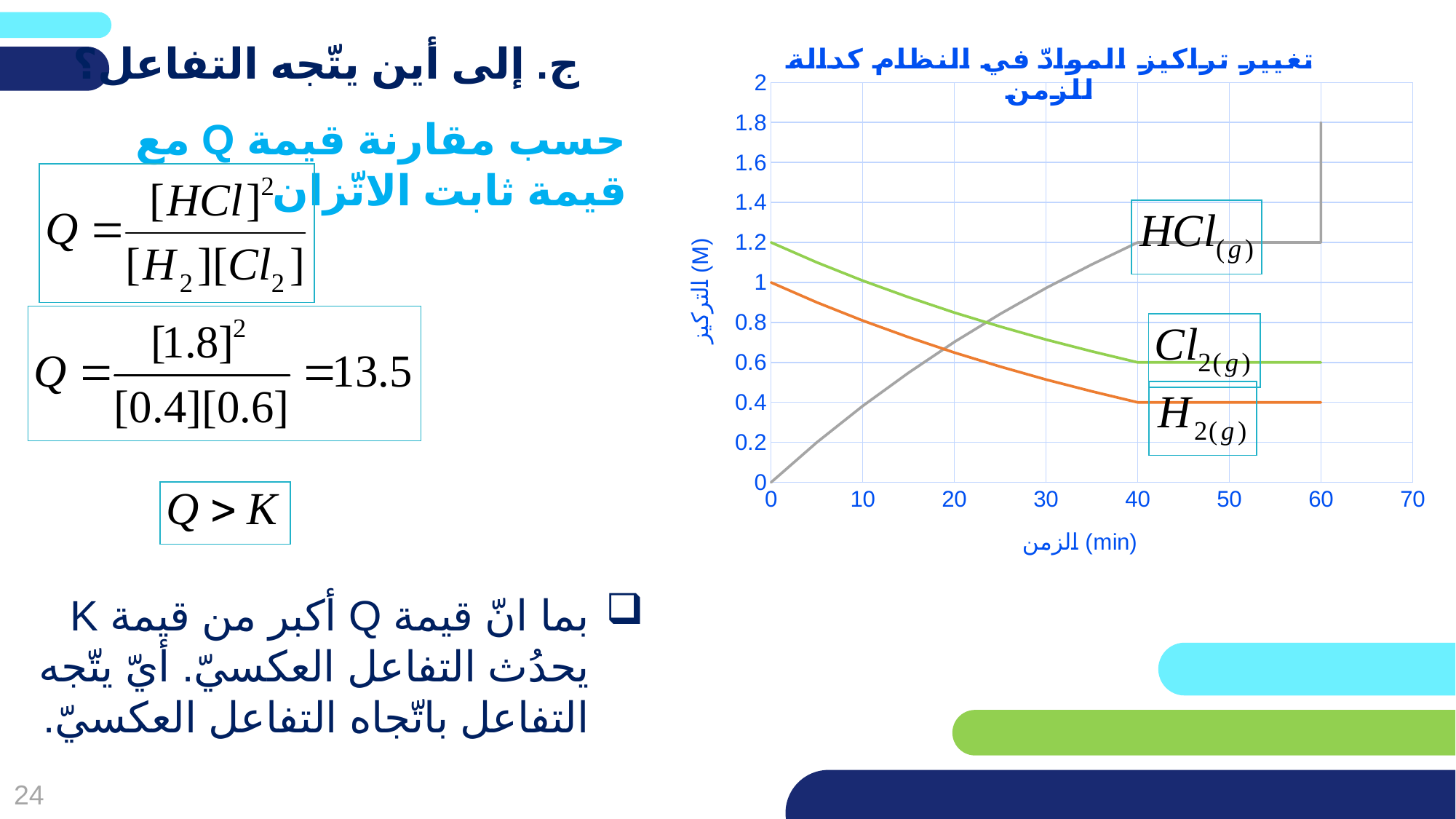
What is the initial concentration of Cl2(g) at 0 min? 1.2 What is the concentration of H2(g) at 40 min? 0.4 What kind of chart is shown on the slide? line chart What is the difference between the concentrations of Cl2(g) and H2(g) at 40 min? 0.2 What is the label of the x axis? الزمن (min) Does the concentration of HCl(g) rise or fall between 0 and 40 min? rise How many series (substances) are plotted on the chart? 3 Is the concentration of Cl2(g) at 20 min greater or less than 0.6? greater What is the concentration of HCl(g) at 40 min? 1.2 What is the initial concentration of H2(g) at 0 min? 1 Which substance has the highest concentration at 50 min? HCl(g) What is the concentration of Cl2(g) at 40 min? 0.6